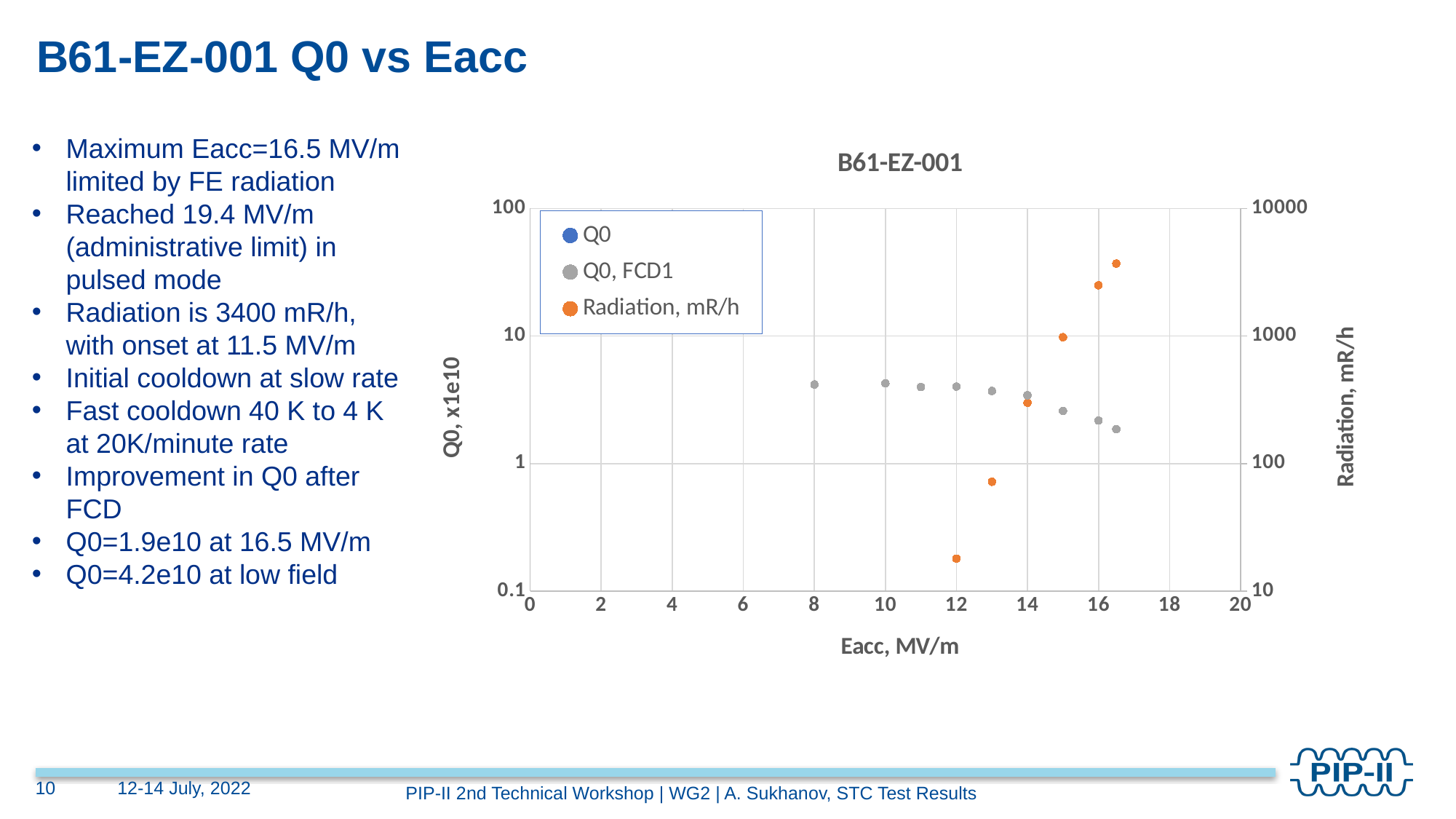
What kind of chart is shown on the slide? scatter chart Is the Radiation value at 16.5 MV/m greater or less than 1000 mR/h? greater Do the Radiation values rise or fall as Eacc increases? rise What is the label of the right-hand vertical axis of the chart? Radiation, mR/h How many series does the chart legend list? 3 Do the Q0, FCD1 values rise or fall as Eacc increases? fall Which is larger, the Q0, FCD1 value at 8 MV/m or at 16.5 MV/m? 8 MV/m At which Eacc value is the Radiation highest? 16.5 MV/m Is the Q0, FCD1 value at 8 MV/m greater or less than 1? greater Is the Q0, FCD1 value at 16.5 MV/m greater or less than 10? less What is the title of the chart? B61-EZ-001